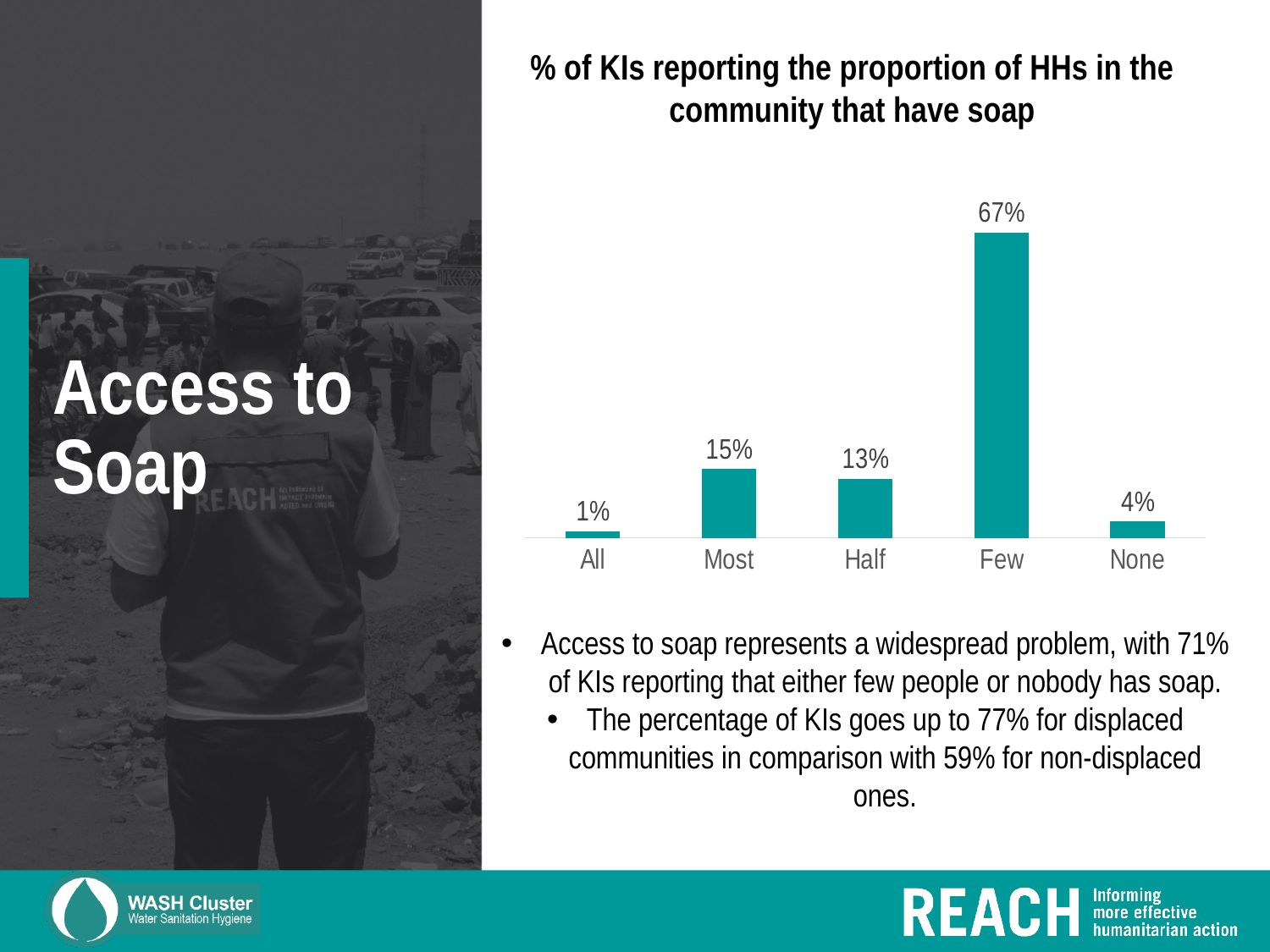
Which category has the lowest percentage of KIs? All What percentage of KIs reported that few households in the community have soap? 67% What percentage of KIs reported that none of the households have soap? 4% How many categories are shown on the x axis of the chart? 5 What is the title of the chart? % of KIs reporting the proportion of HHs in the community that have soap What is the value shown for the 'Most' category? 15% What is the difference between the values for 'Few' and 'Most'? 52% Which category has the highest percentage of KIs? Few What kind of chart is shown on the slide? Bar chart What is the combined value of the 'Few' and 'None' categories? 71% What is the difference between the values for 'Most' and 'Half'? 2% Which is larger, the value for 'Half' or the value for 'None'? Half